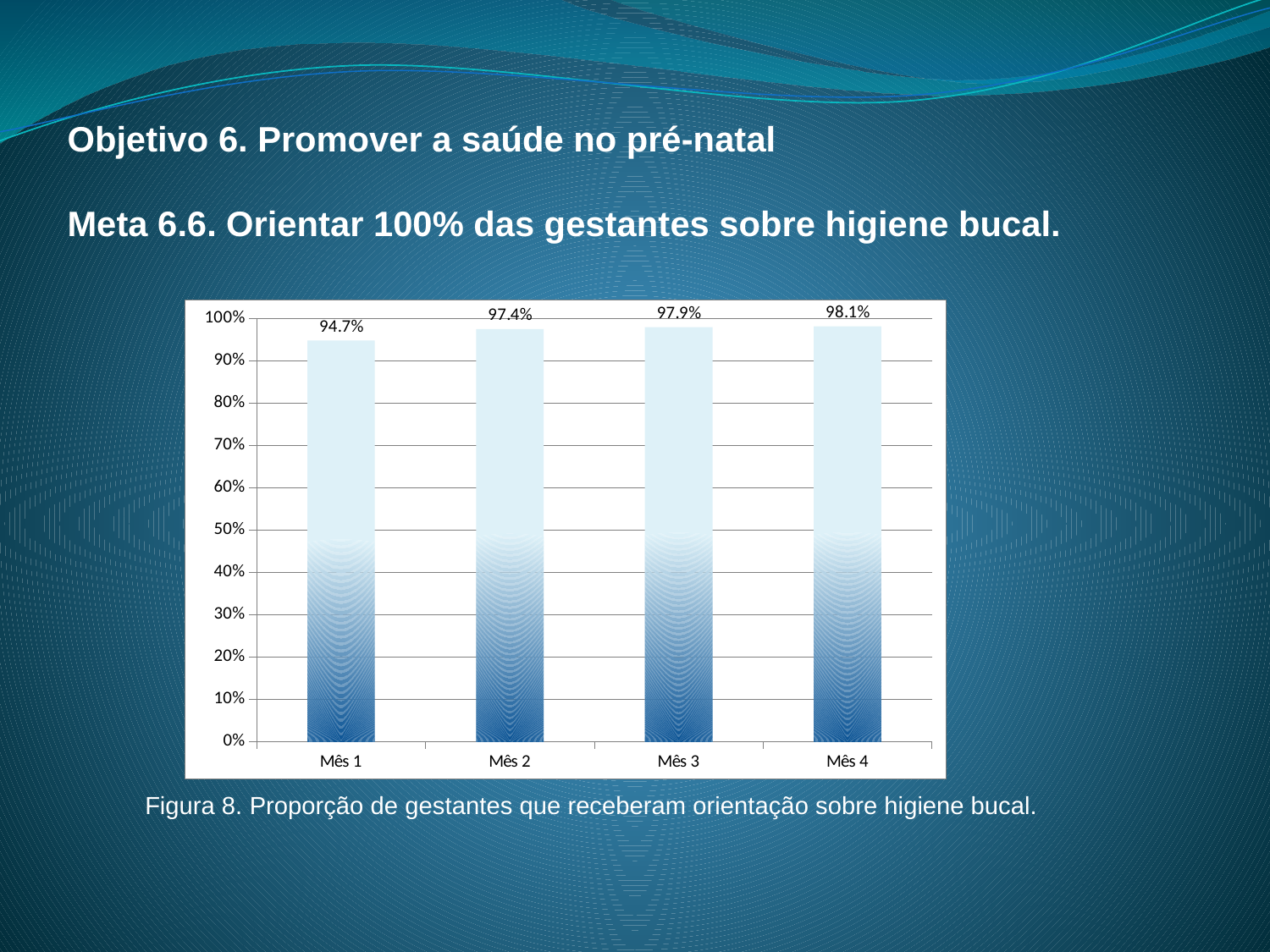
What is the value for Mês 3? 97.9% Which month has the highest value? Mês 4 Which month has the lowest value? Mês 1 Which is larger, the value for Mês 1 or the value for Mês 2? Mês 2 What kind of chart is shown on the slide? Bar chart What is the value for Mês 4? 98.1% What is the value for Mês 1? 94.7% What is the difference between the values for Mês 2 and Mês 1? 2.7% What is the difference between the values for Mês 4 and Mês 1? 3.4% Do the values rise or fall from Mês 1 to Mês 4? Rise How many months are shown on the x axis? 4 What is the value for Mês 2? 97.4%